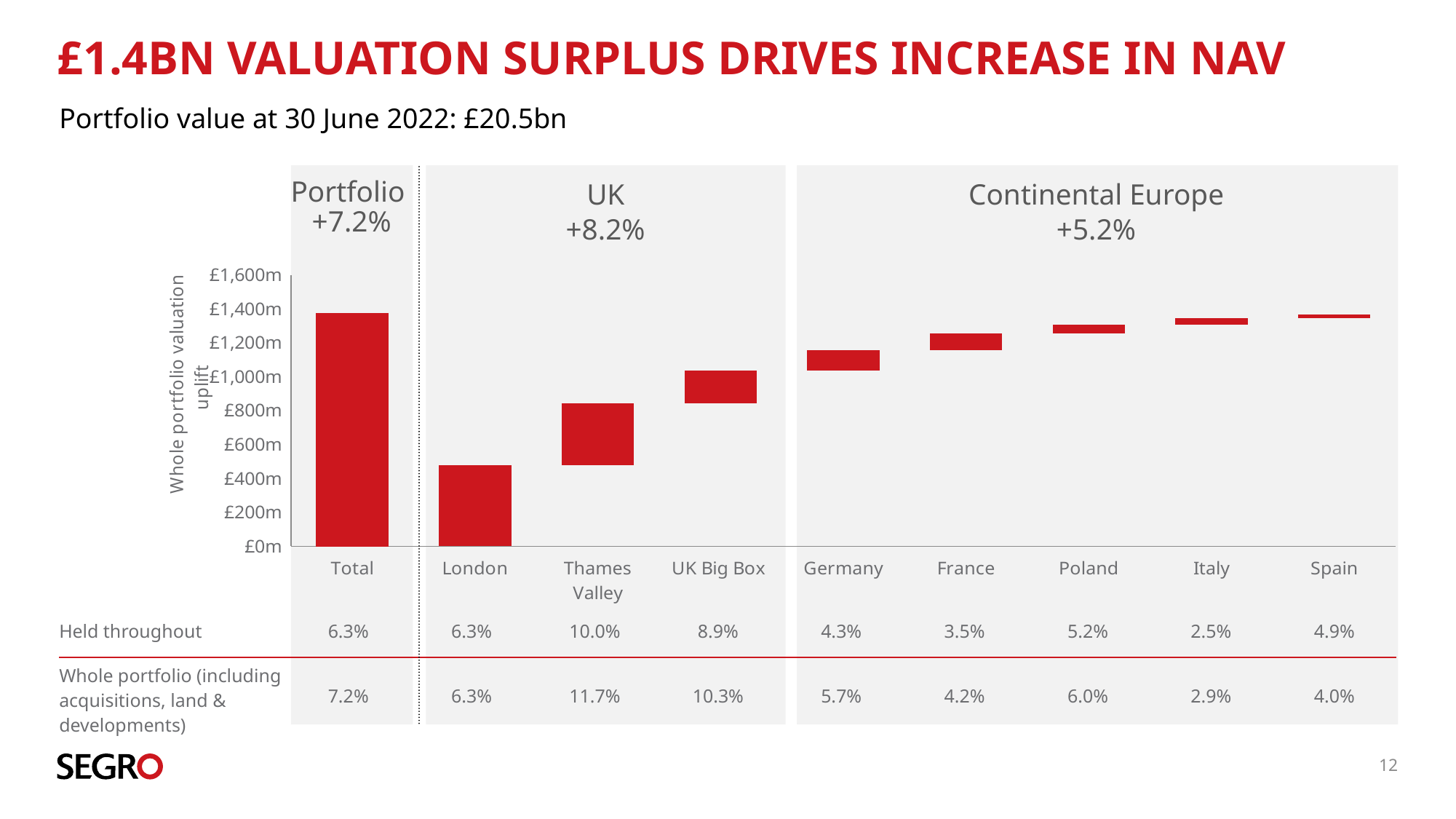
Is the valuation uplift for UK Big Box greater or less than £400m? less What is the 'Whole portfolio (including acquisitions, land & developments)' valuation change shown for Poland? 6.0% Is the valuation uplift for London greater or less than £400m? greater Which individual market contributes the smallest valuation uplift in the chart? Spain How many categories are shown along the x axis of the chart? 9 Is the value of the Total bar greater or less than £1,200m? greater What is the 'Held throughout' valuation change shown for Thames Valley? 10.0% What kind of chart is shown on the slide? Bar chart (waterfall) What is the highest value labelled on the y axis of the chart? £1,600m Which contributes a larger valuation uplift, Thames Valley or Germany? Thames Valley Which individual market (excluding Total) contributes the largest valuation uplift in the chart? London What percentage uplift is shown in the header for Continental Europe? +5.2%